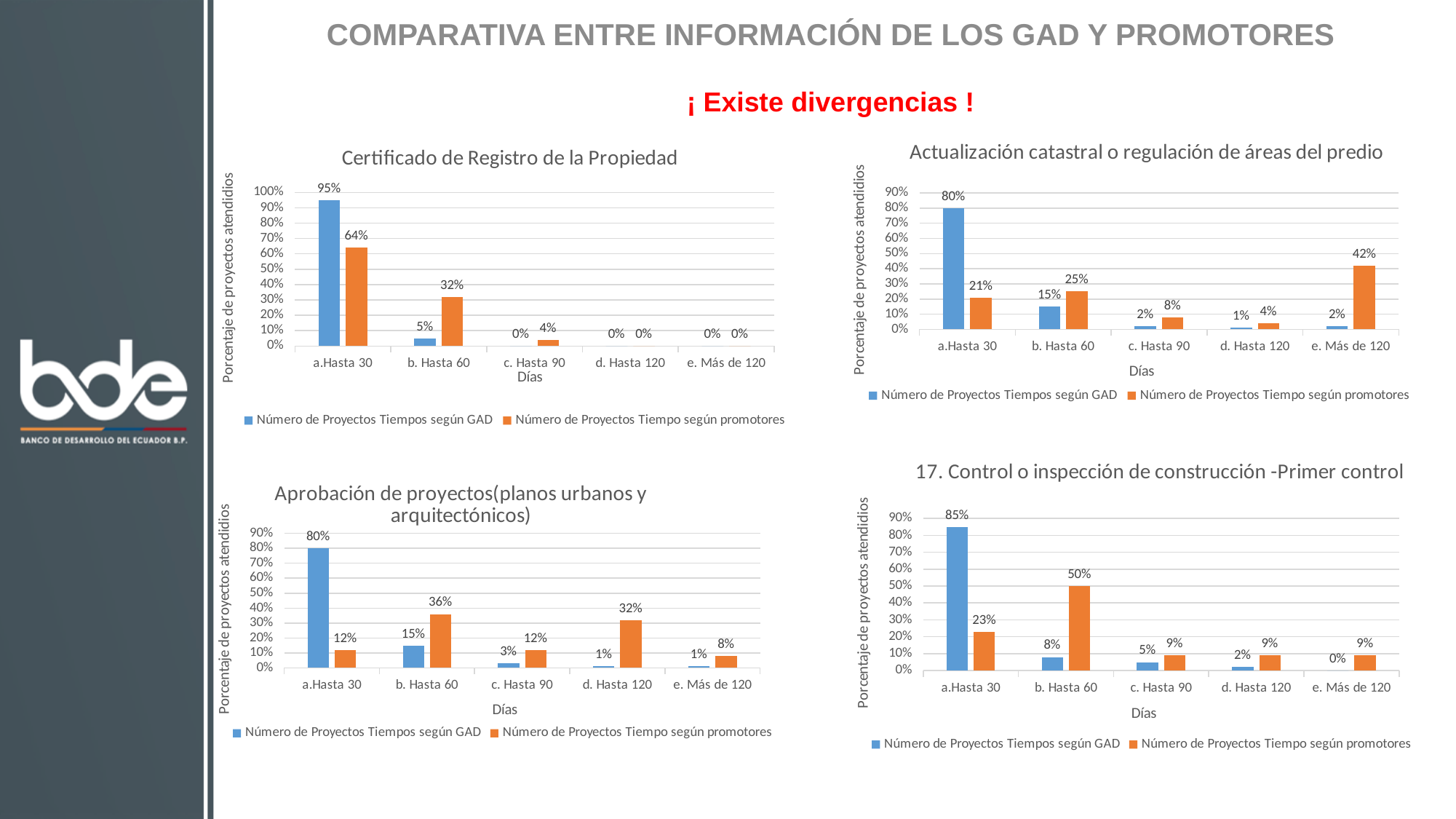
In the '17. Control o inspección de construcción -Primer control' chart, which is larger for 'a.Hasta 30': the GAD value or the promotores value? GAD value In the 'Actualización catastral o regulación de áreas del predio' chart, what is the value for 'e. Más de 120' according to promotores? 42% How many categories are shown on the x axis of the 'Certificado de Registro de la Propiedad' chart? 5 In the 'Actualización catastral o regulación de áreas del predio' chart, which category has the highest value according to GAD? a.Hasta 30 In the '17. Control o inspección de construcción -Primer control' chart, what is the difference between the GAD and promotores values for 'a.Hasta 30'? 62% What kind of chart is the 'Aprobación de proyectos(planos urbanos y arquitectónicos)' chart? Bar chart In the 'Aprobación de proyectos(planos urbanos y arquitectónicos)' chart, which category has the highest value according to promotores? b. Hasta 60 In the '17. Control o inspección de construcción -Primer control' chart, what is the value for 'b. Hasta 60' according to promotores? 50% In the 'Certificado de Registro de la Propiedad' chart, what is the value for 'a.Hasta 30' according to GAD? 95% In the 'Certificado de Registro de la Propiedad' chart, what is the value for 'b. Hasta 60' according to promotores? 32% In the 'Aprobación de proyectos(planos urbanos y arquitectónicos)' chart, what is the difference between the GAD and promotores values for 'd. Hasta 120'? 31% How many series does the legend of the 'Actualización catastral o regulación de áreas del predio' chart list? 2